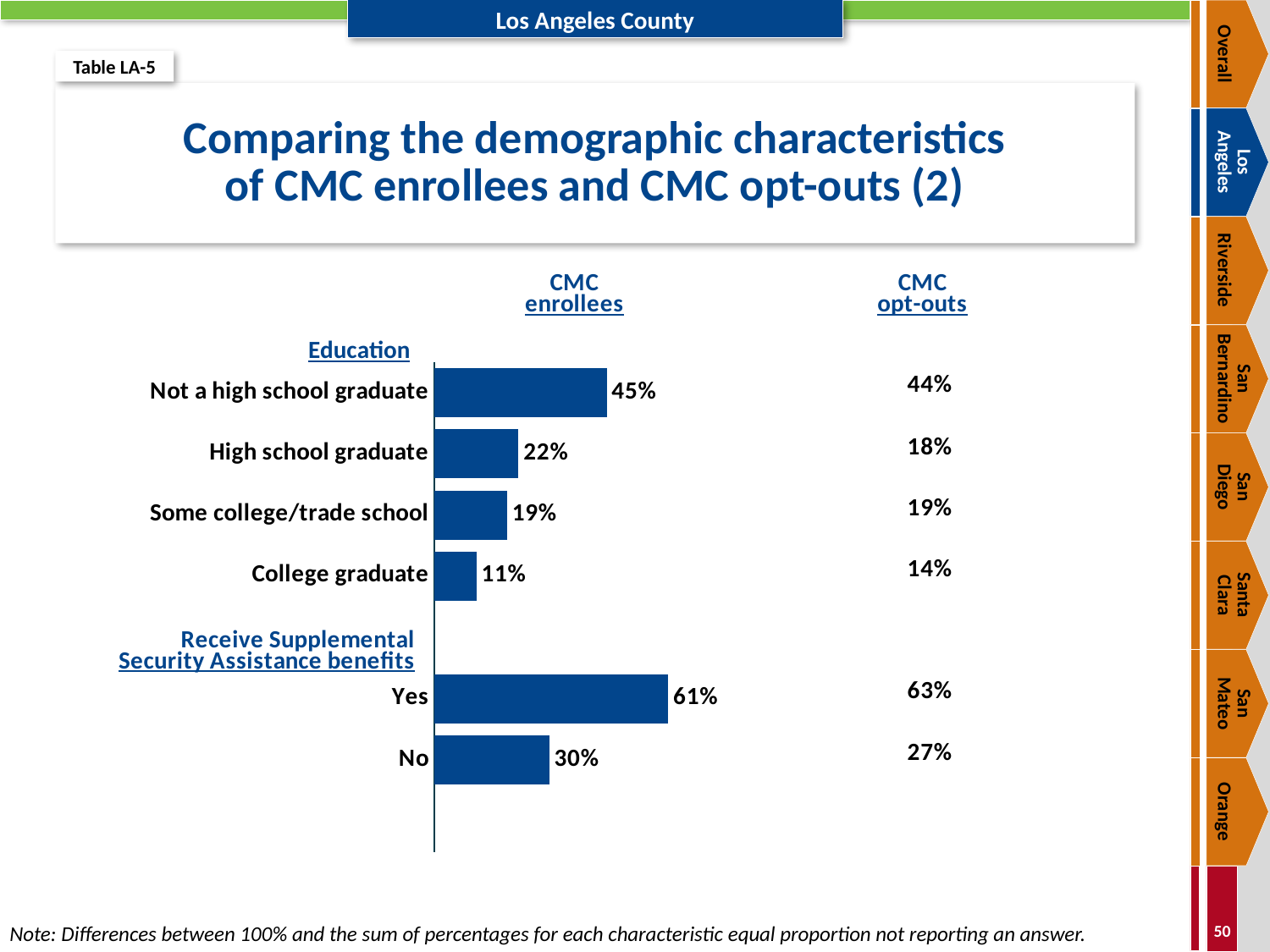
What percentage of CMC enrollees are not a high school graduate? 45% Which education category has the lowest percentage among CMC enrollees? College graduate Which education category has the highest percentage among CMC enrollees? Not a high school graduate What is the difference between the Yes and No percentages for CMC enrollees receiving Supplemental Security Assistance benefits? 31% What percentage of CMC enrollees receive Supplemental Security Assistance benefits (Yes)? 61% What type of chart is used to show the CMC enrollee percentages? Bar chart How many education categories are shown in the chart? 4 What is the difference between the CMC enrollee and CMC opt-out percentages for High school graduate? 4% What percentage of CMC opt-outs answered No to receiving Supplemental Security Assistance benefits? 27% What is the title of the chart on the slide? Comparing the demographic characteristics of CMC enrollees and CMC opt-outs (2) What percentage of CMC opt-outs are college graduates? 14% Which is larger: the percentage of CMC enrollees or CMC opt-outs who are college graduates? CMC opt-outs